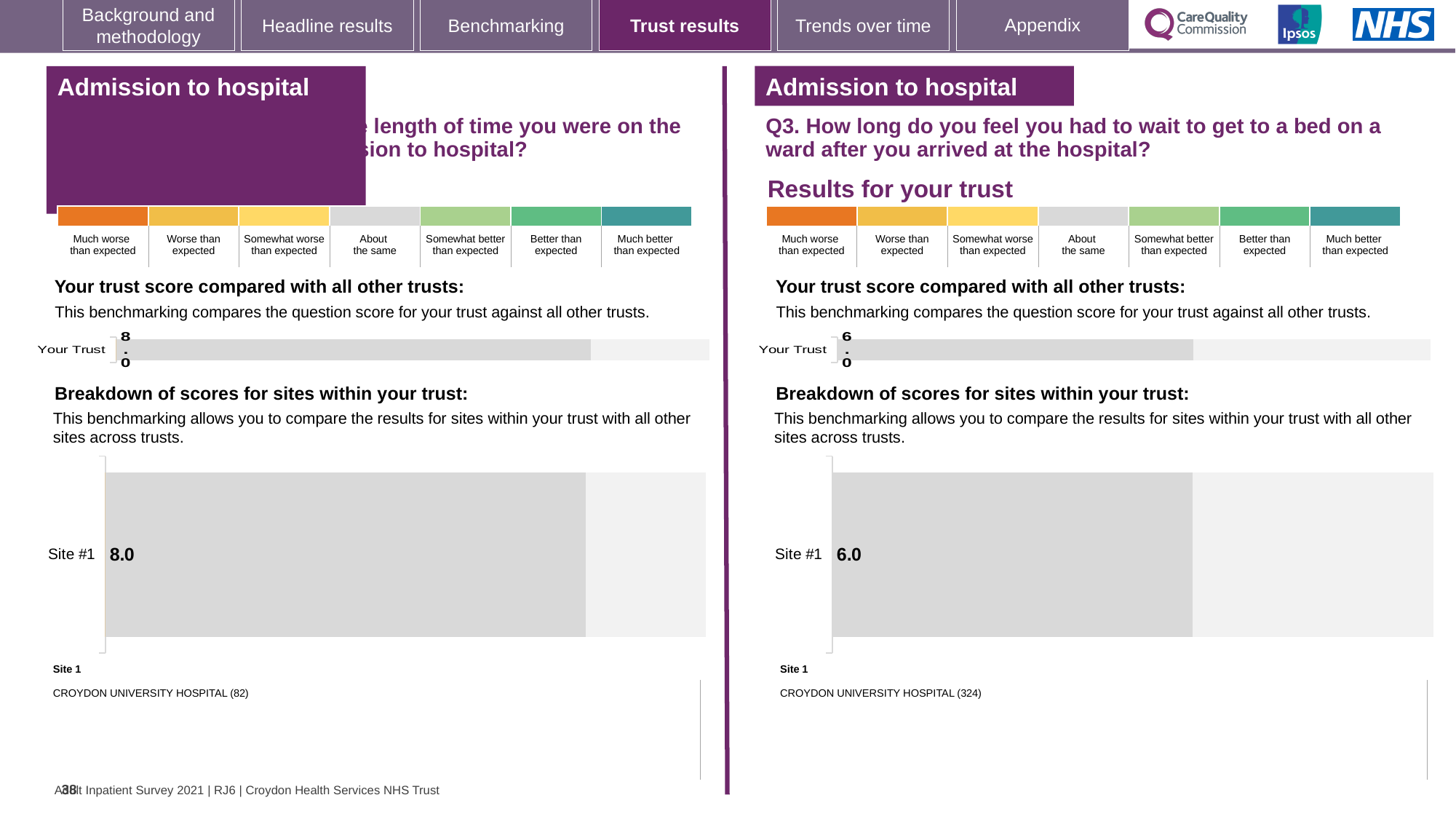
On the left-hand 'Your trust score compared with all other trusts' chart, what is the value shown for Your Trust? 8.0 On the right-hand 'Your trust score compared with all other trusts' chart (Q3), what is the value shown for Your Trust? 6.0 Which is larger: the Site #1 score on the left-hand breakdown chart or the Site #1 score on the right-hand breakdown chart (Q3)? Left-hand chart (8.0) On the right-hand 'Breakdown of scores for sites within your trust' chart (Q3), what is the score for Site #1? 6.0 On the left-hand 'Breakdown of scores for sites within your trust' chart, what is the score for Site #1? 8.0 How many bars are shown on the right-hand 'Your trust score compared with all other trusts' chart (Q3)? 1 What type of chart is used for the 'Breakdown of scores for sites within your trust' on the right-hand side (Q3)? Bar chart On the right-hand breakdown chart (Q3), which site is labelled as Site 1? CROYDON UNIVERSITY HOSPITAL (324) How many sites are plotted on the left-hand 'Breakdown of scores for sites within your trust' chart? 1 On the left-hand breakdown chart, which site is labelled as Site 1? CROYDON UNIVERSITY HOSPITAL (82) What is the difference between the Site #1 score on the left-hand breakdown chart and the Site #1 score on the right-hand breakdown chart (Q3)? 2.0